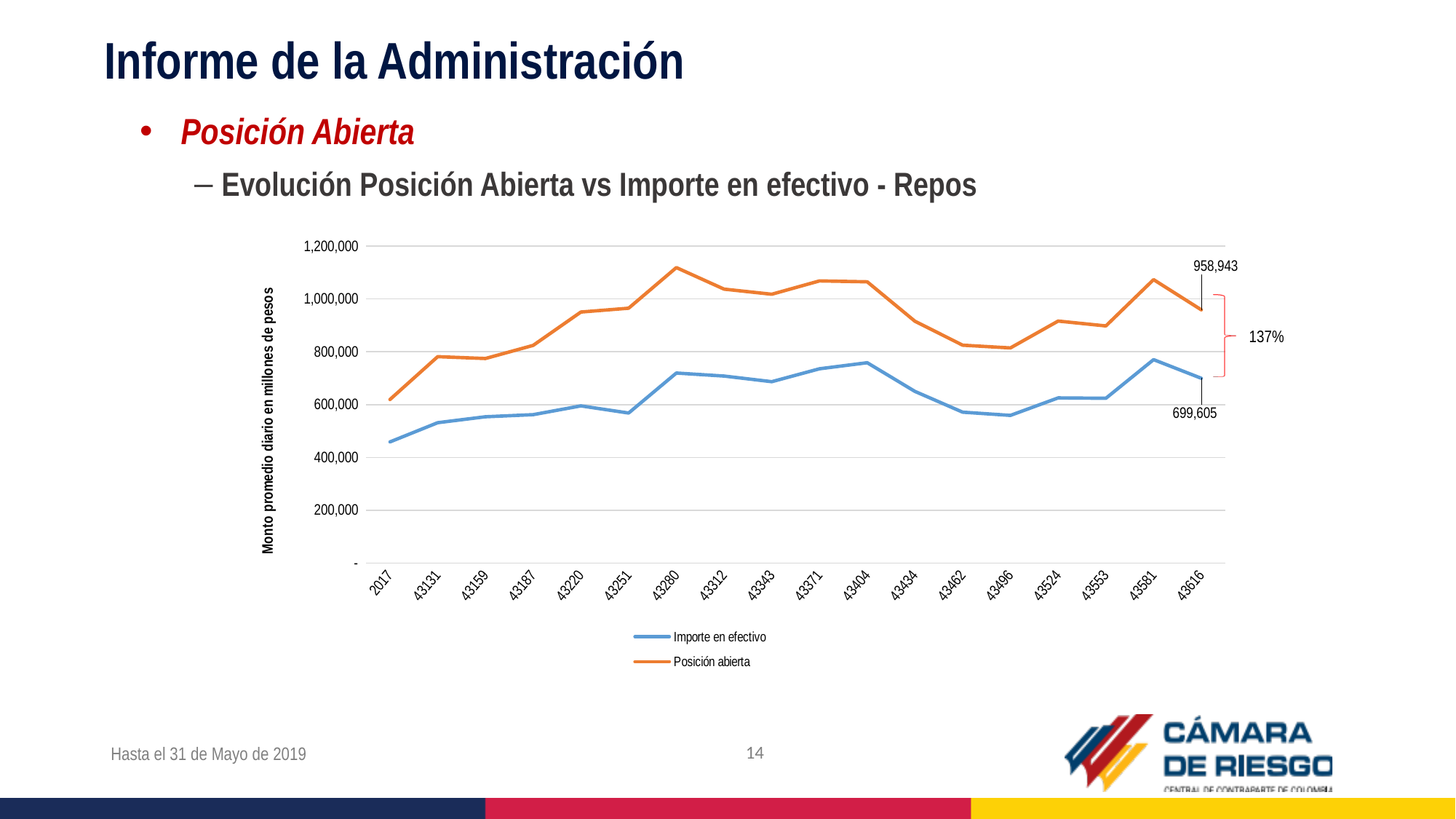
What is the difference between Posición abierta and Importe en efectivo at 43616? 259,338 Does Importe en efectivo rise or fall from 2017 to 43220? rise At 43616, which series has the larger value, Posición abierta or Importe en efectivo? Posición abierta What is the value of Posición abierta at 43616? 958,943 What kind of chart is shown on the slide? line chart What is the title of the y axis? Monto promedio diario en millones de pesos How many points are plotted along the x axis? 18 What is the value of Importe en efectivo at 43616? 699,605 How many series does the legend list? 2 Is the value for Importe en efectivo at 2017 greater or less than 600,000? less Is the value for Posición abierta at 43280 greater or less than 1,000,000? greater At which x-axis label does Posición abierta reach its highest value? 43280